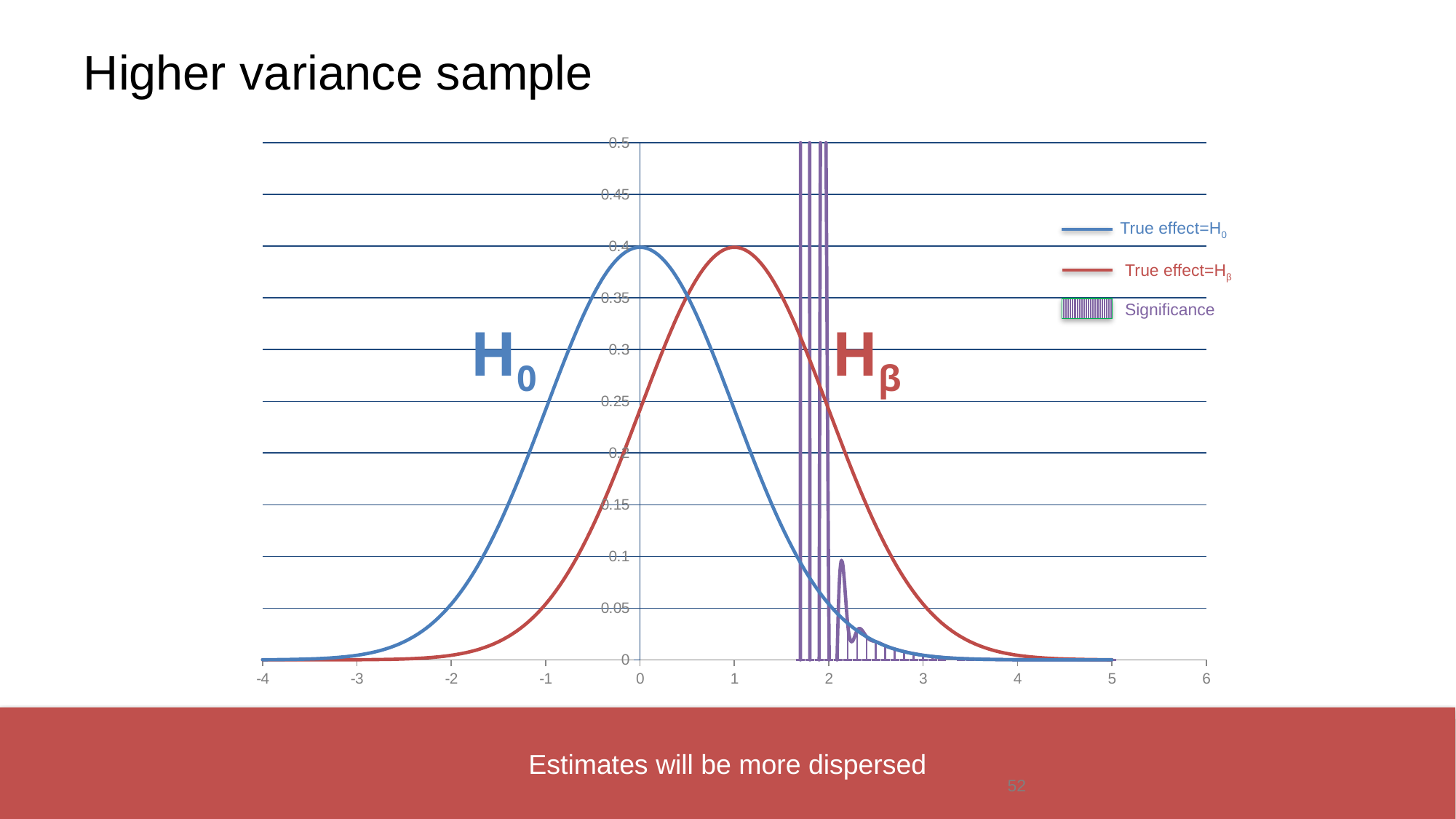
At what x value does the True effect=Hβ curve reach its peak? 1 What is the range of the x axis? -4 to 6 At x = 2, which curve is higher, True effect=H0 or True effect=Hβ? True effect=Hβ What kind of chart is shown on the slide? line chart At what x value does the True effect=H0 curve reach its peak? 0 Is the value of the True effect=H0 curve at x = 1 greater or less than 0.3? less What colour is used for the Significance region in the legend? purple How many series does the legend list? 3 Does the True effect=H0 curve rise or fall as x goes from 0 to 4? fall What is the peak value of the True effect=H0 curve? 0.4 At x = -1, which curve is higher, True effect=H0 or True effect=Hβ? True effect=H0 Is the value of the True effect=H0 curve at x = 2 greater or less than 0.1? less